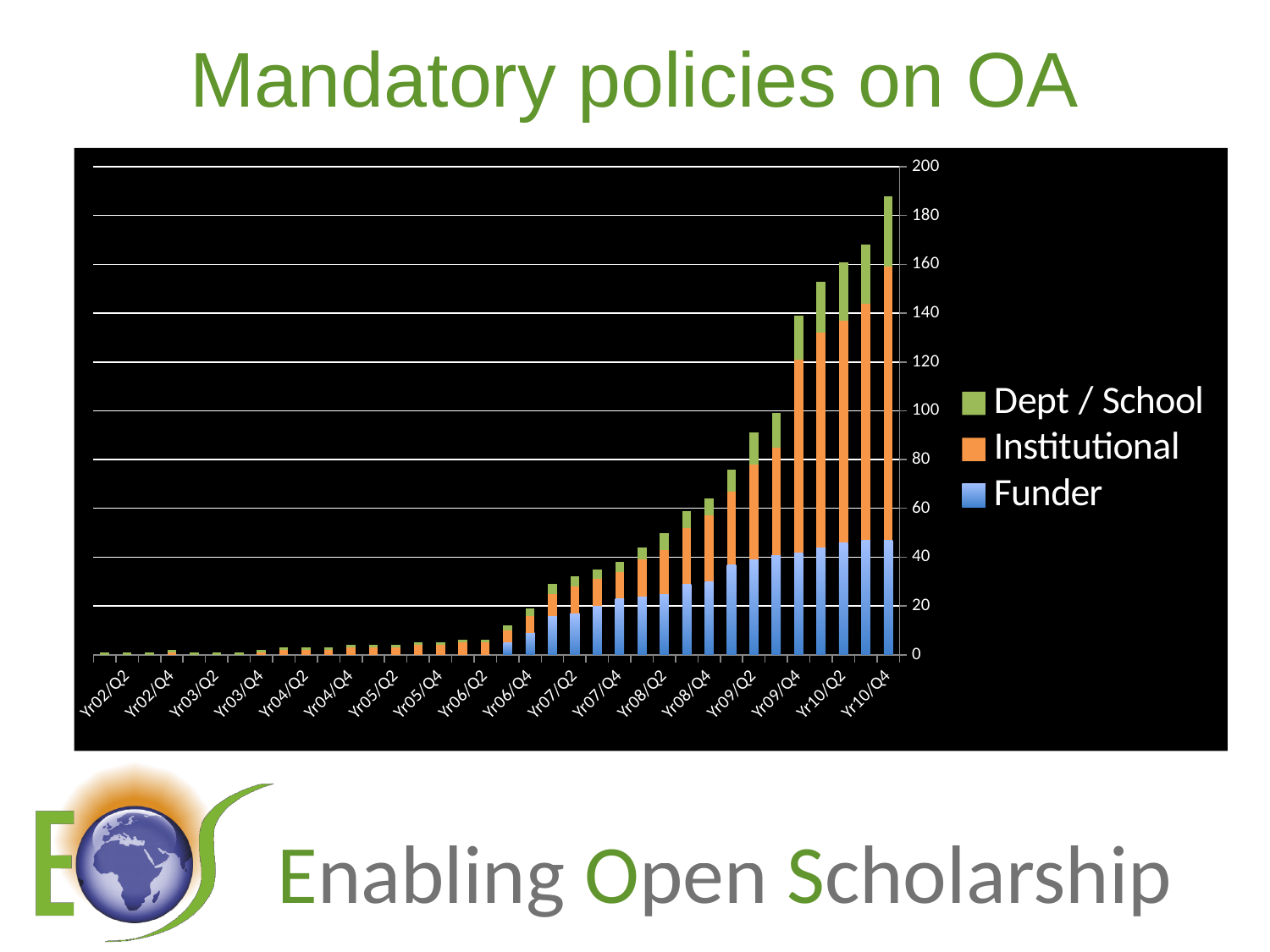
Is the total value for Yr09/Q4 greater or less than 120? greater Is the total value for Yr08/Q2 greater or less than 60? less Which series are listed in the chart legend? Dept / School, Institutional, Funder Which quarter has the highest total bar? Yr10/Q4 Is the total value for Yr10/Q4 greater or less than 180? greater Which has the larger total bar, Yr09/Q4 or Yr10/Q4? Yr10/Q4 Do the total values generally rise or fall from Yr02/Q2 to Yr10/Q4? Rise What kind of chart is shown on the slide? Stacked bar chart How many series does the chart legend list? 3 What colour represents the Funder series? Blue